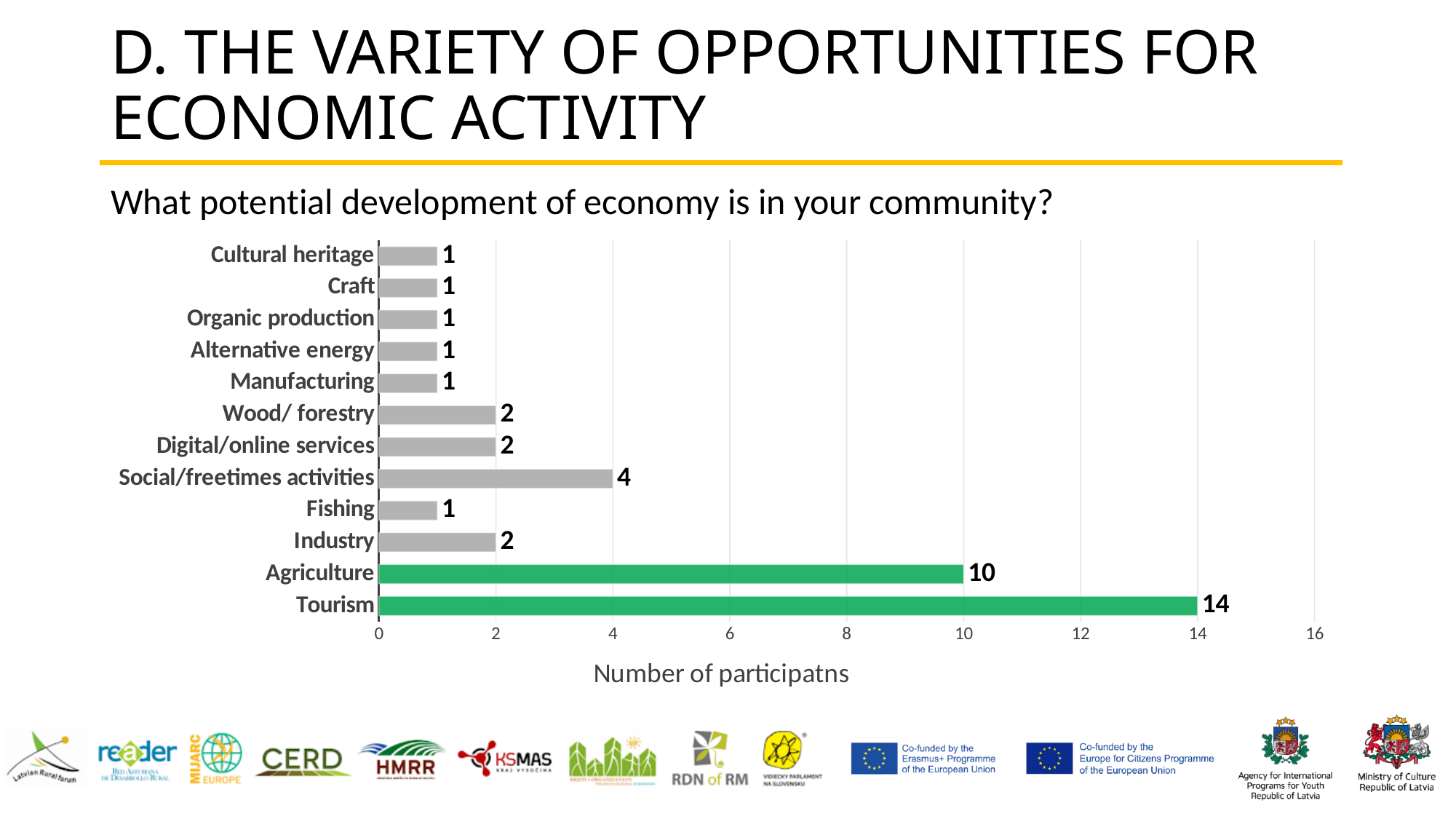
Is the value for Agriculture greater or less than 8? greater Which category has the highest number of participants? Tourism How many categories are shown in the chart? 12 What is the difference in number of participants between Tourism and Agriculture? 4 Which has more participants, Industry or Social/freetimes activities? Social/freetimes activities Which two categories are shown with green bars? Agriculture and Tourism What kind of chart is shown on the slide? Bar chart What is the number of participants for Social/freetimes activities? 4 What is the number of participants for Agriculture? 10 What is the number of participants for Wood/ forestry? 2 What is the label of the horizontal axis? Number of participatns What is the number of participants for Tourism? 14